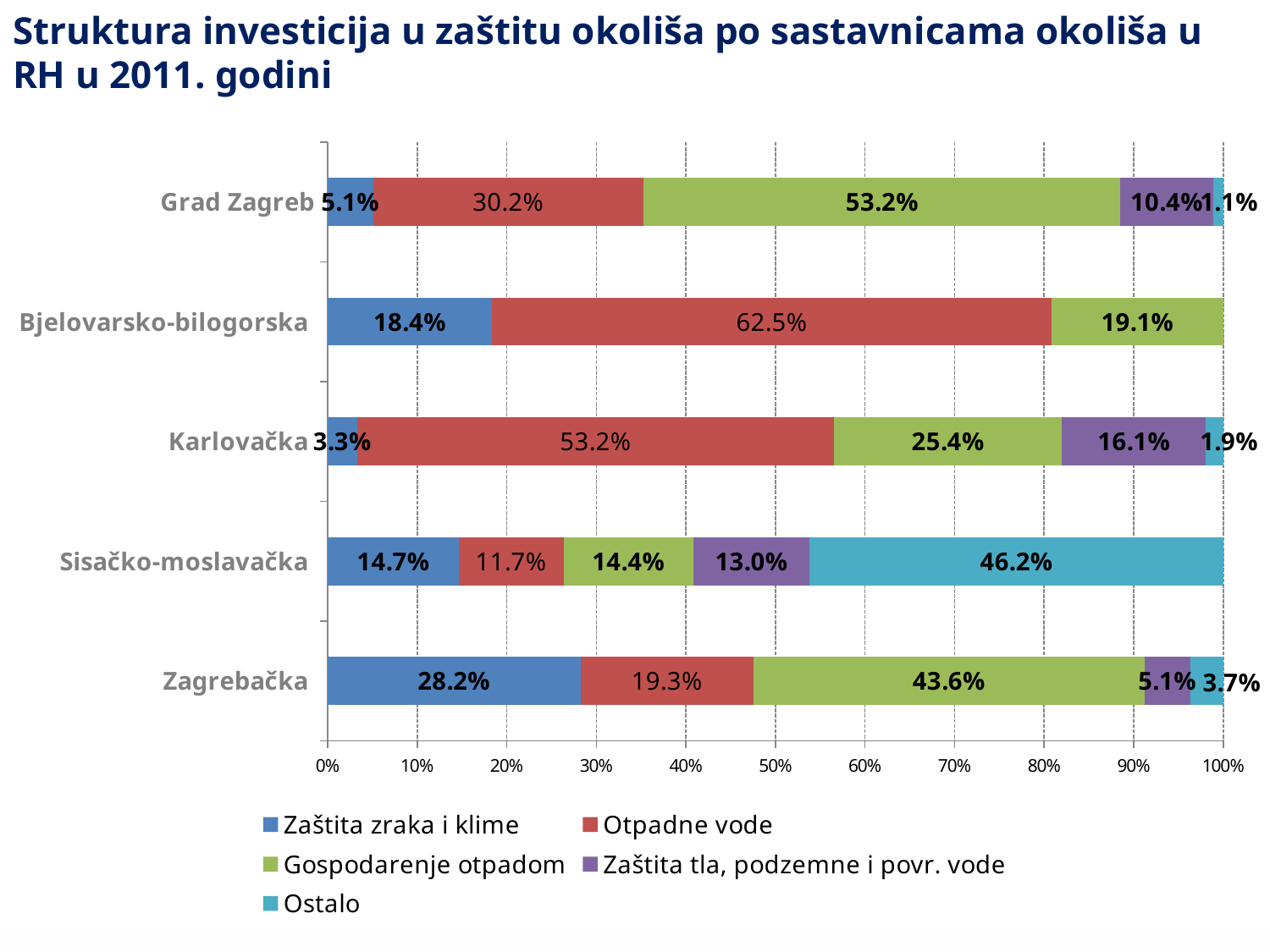
How many series does the legend list? 5 What is the Otpadne vode share for Bjelovarsko-bilogorska? 62.5% What share of environmental protection investment in Grad Zagreb goes to Gospodarenje otpadom? 53.2% How many counties/regions are shown on the chart? 5 Which county has the lowest Zaštita zraka i klime share? Karlovačka What is the Zaštita zraka i klime share for Zagrebačka? 28.2% What is the Ostalo share for Sisačko-moslavačka? 46.2% For Grad Zagreb, how many percentage points larger is the Gospodarenje otpadom share than the Otpadne vode share? 23.0 percentage points What kind of chart is shown on the slide? Stacked bar chart Which county has the highest Otpadne vode share? Bjelovarsko-bilogorska What is the Zaštita tla, podzemne i povr. vode share for Karlovačka? 16.1% For Zagrebačka, which is larger: the Gospodarenje otpadom share or the Otpadne vode share? Gospodarenje otpadom